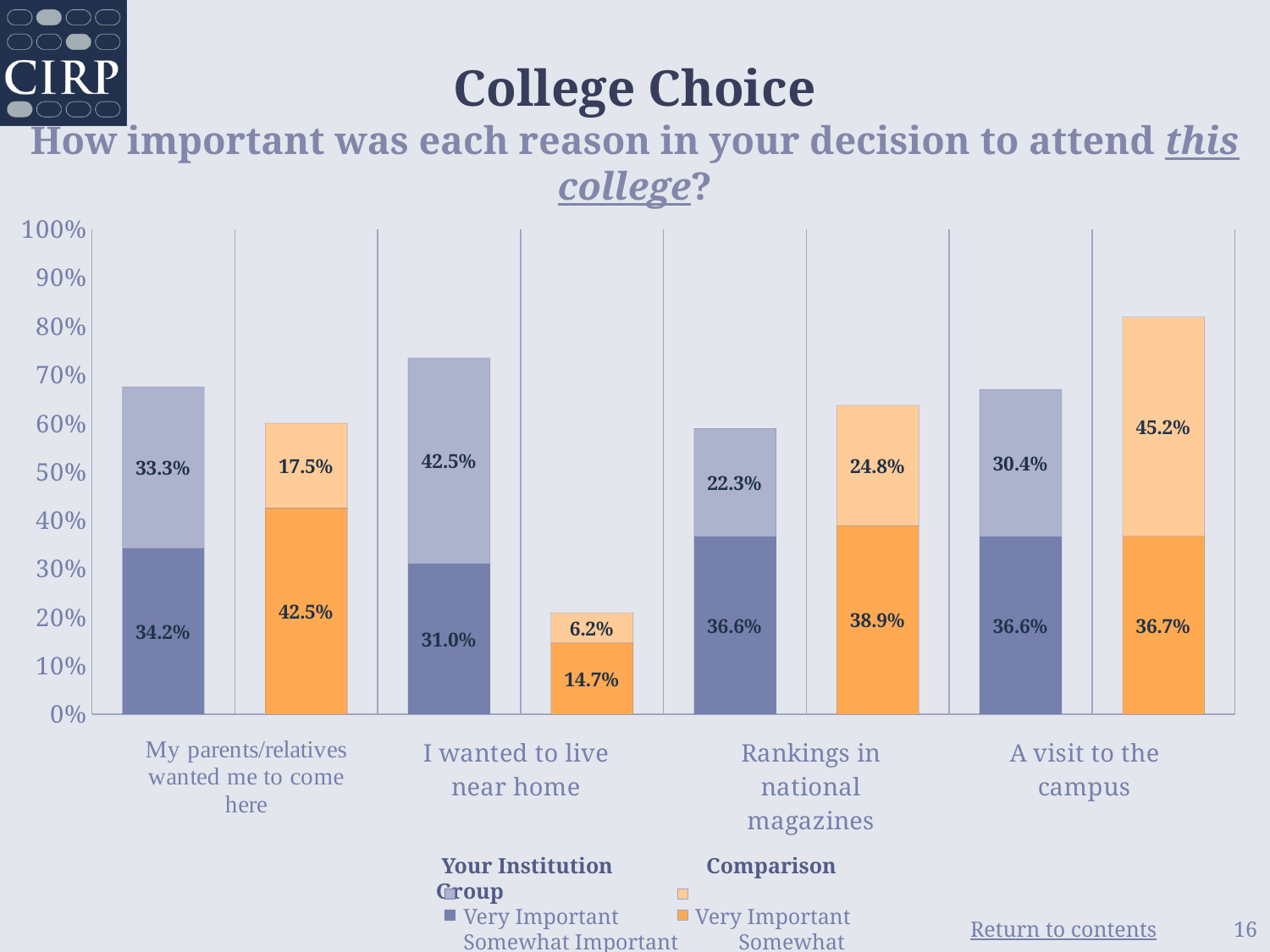
Which is larger for 'Rankings in national magazines': the Your Institution Somewhat Important value or the Comparison Group Somewhat Important value? Comparison Group (24.8%) What percentage of the Comparison Group rated 'My parents/relatives wanted me to come here' as Very Important? 42.5% Which reason has the lowest Comparison Group Very Important value? I wanted to live near home What is the difference between the Your Institution and Comparison Group Very Important values for 'I wanted to live near home'? 16.3 percentage points Is the total height of the Comparison Group bar for 'A visit to the campus' greater or less than 80%? greater What is the total (Very Important plus Somewhat Important) for the Comparison Group bar for 'I wanted to live near home'? 20.9% What is the total (Very Important plus Somewhat Important) for the Your Institution bar for 'A visit to the campus'? 67.0% What kind of chart is shown on the slide? Stacked bar chart How many series does the legend list? 4 What percentage of Your Institution students rated 'I wanted to live near home' as Very Important? 31.0% How many reasons (categories) are shown along the x axis? 4 What percentage of the Comparison Group rated 'A visit to the campus' as Somewhat Important? 45.2%